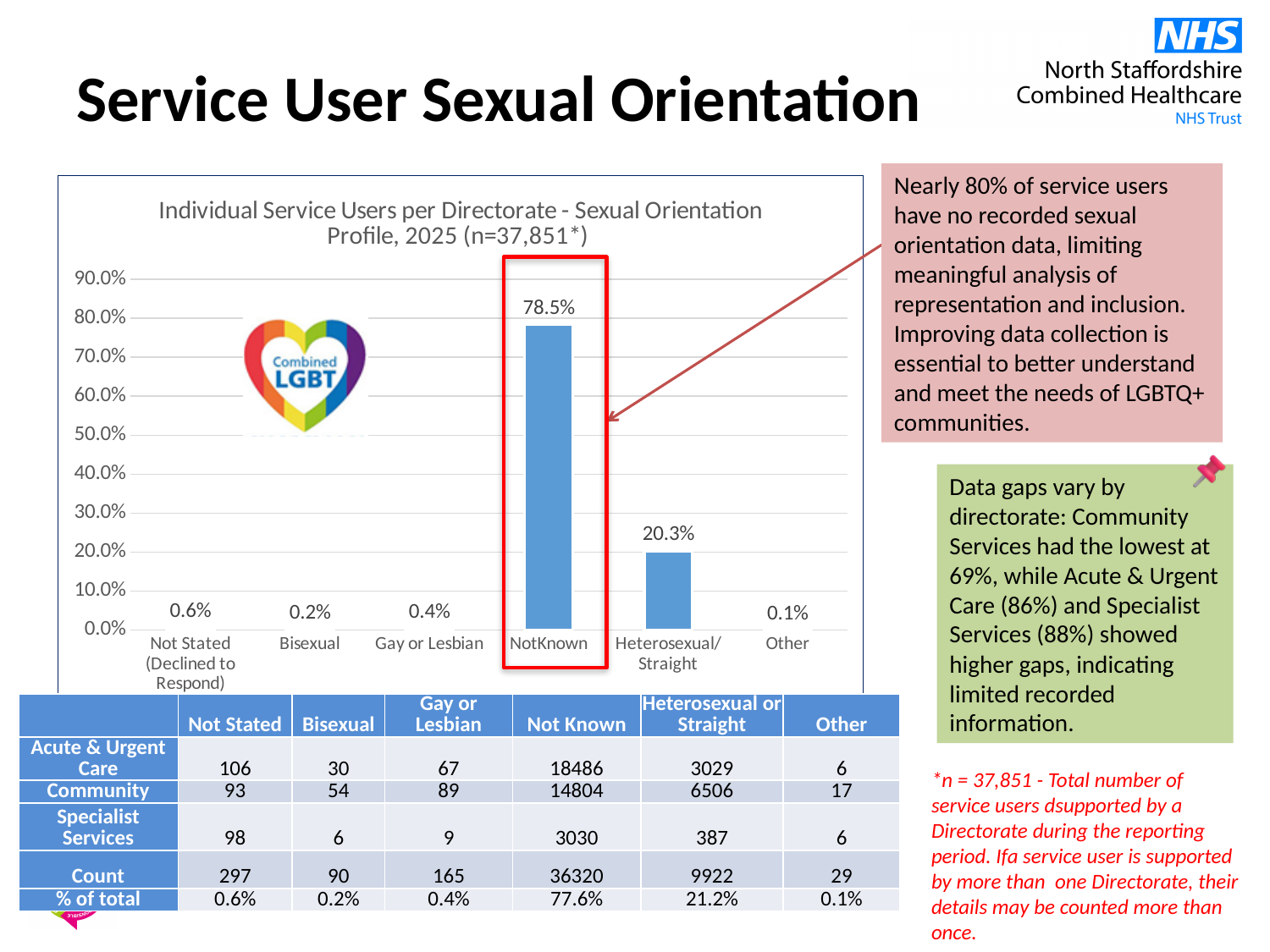
What value does the chart show for Heterosexual/Straight? 20.3% Which category has the lowest value in the chart? Other What kind of chart is shown on the slide? Bar chart What value does the chart show for NotKnown? 78.5% Which category has the highest value in the chart? NotKnown What is the title of the chart? Individual Service Users per Directorate - Sexual Orientation Profile, 2025 (n=37,851*) Is the value for Heterosexual/Straight greater or less than 30.0%? less How many categories are shown on the x axis of the chart? 6 What value does the chart show for Gay or Lesbian? 0.4% What is the difference between the NotKnown and Heterosexual/Straight values in the chart? 58.2% What value does the chart show for Not Stated (Declined to Respond)? 0.6% Which is larger in the chart, the value for Bisexual or the value for Gay or Lesbian? Gay or Lesbian